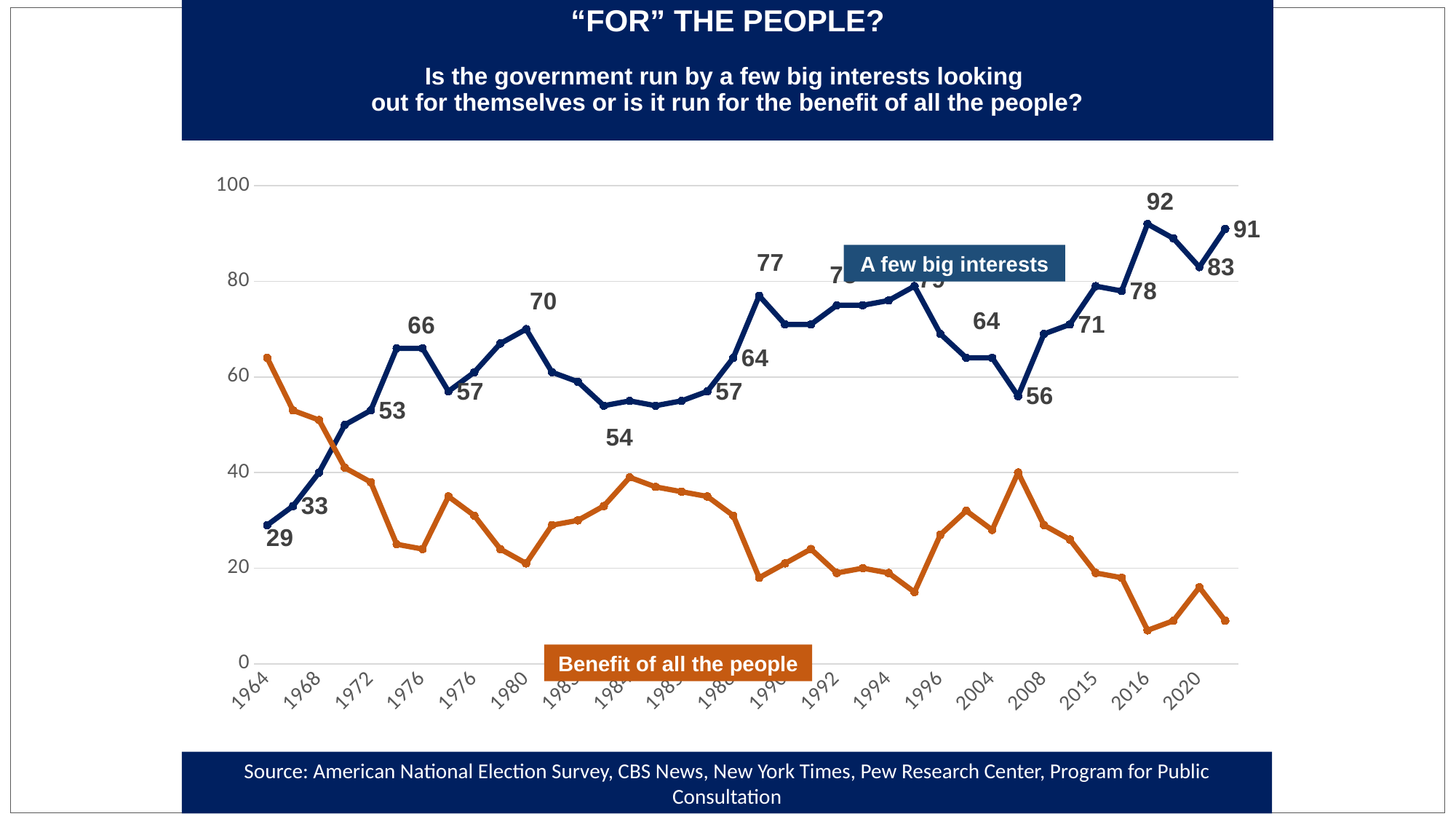
How many series are plotted on the chart? 2 What is the difference between the peak value of 92 and the 1964 value of 29 for "A few big interests"? 63 Is the value for "Benefit of all the people" in 1964 greater or less than 60? greater Is the final value for "Benefit of all the people" at the right end of the chart greater or less than 20? less What is the highest labelled value on the "A few big interests" line? 92 At the right end of the chart, which series has the higher value: "A few big interests" or "Benefit of all the people"? A few big interests What is the value for "A few big interests" in 1964? 29 What is the final labelled value at the right end of the "A few big interests" line? 91 What kind of chart is shown on the slide? line chart Overall, does the "A few big interests" line rise or fall from 1964 to the right end of the chart? rise What is the lowest labelled value on the "A few big interests" line? 29 In 1964, which series has the higher value: "A few big interests" or "Benefit of all the people"? Benefit of all the people